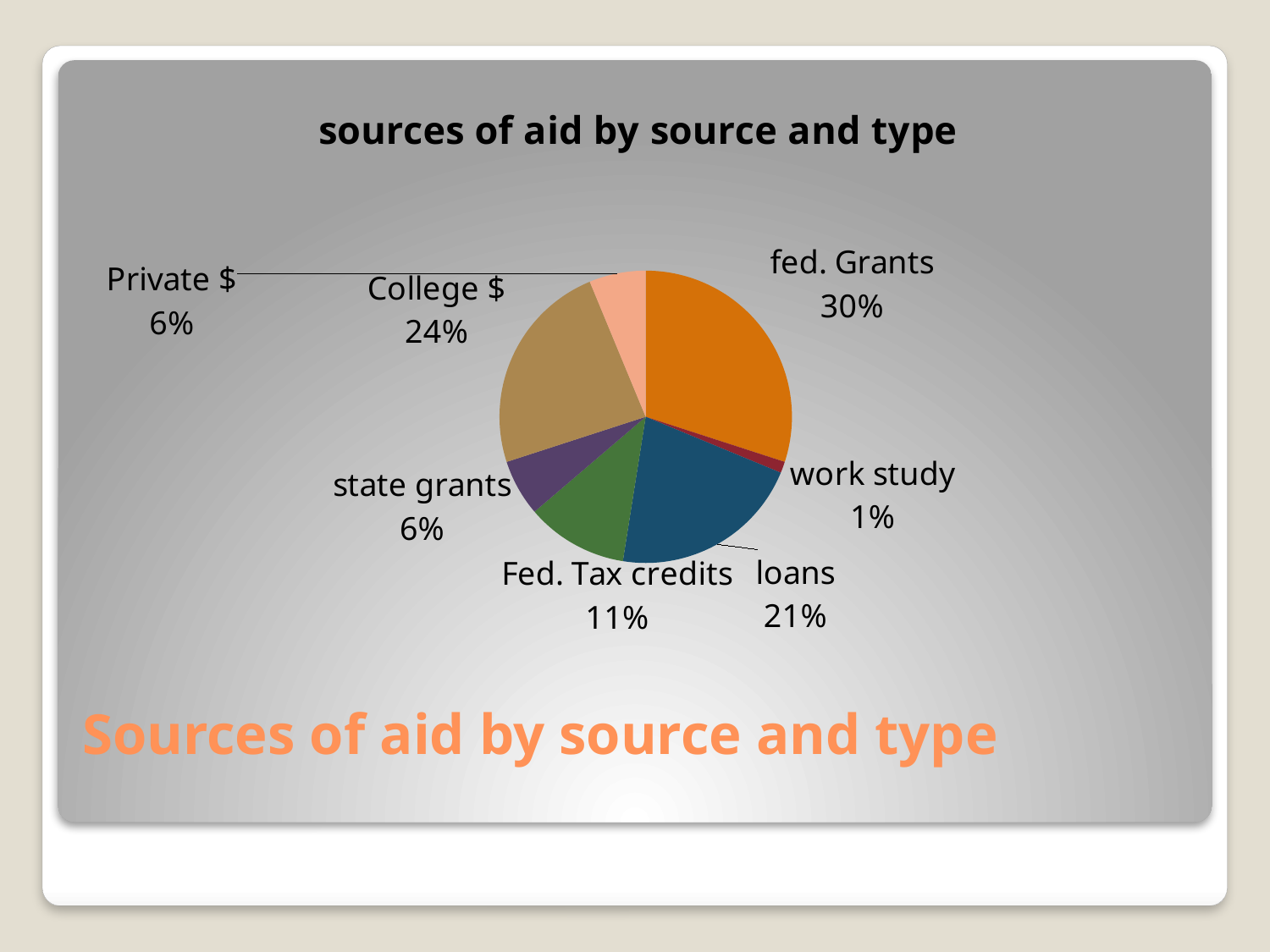
What share of aid comes from fed. Grants? 30% What type of chart is shown on the slide? pie chart How many slices does the pie chart have? 7 What is the chart's title? sources of aid by source and type Which source has the smallest share of aid? work study Which is larger, the share for College $ or the share for loans? College $ What share of aid comes from College $? 24% What share of aid comes from loans? 21% What is the difference in percentage points between fed. Grants and loans? 9 What share of aid comes from work study? 1% What share of aid comes from Fed. Tax credits? 11% Which source has the largest share of aid? fed. Grants